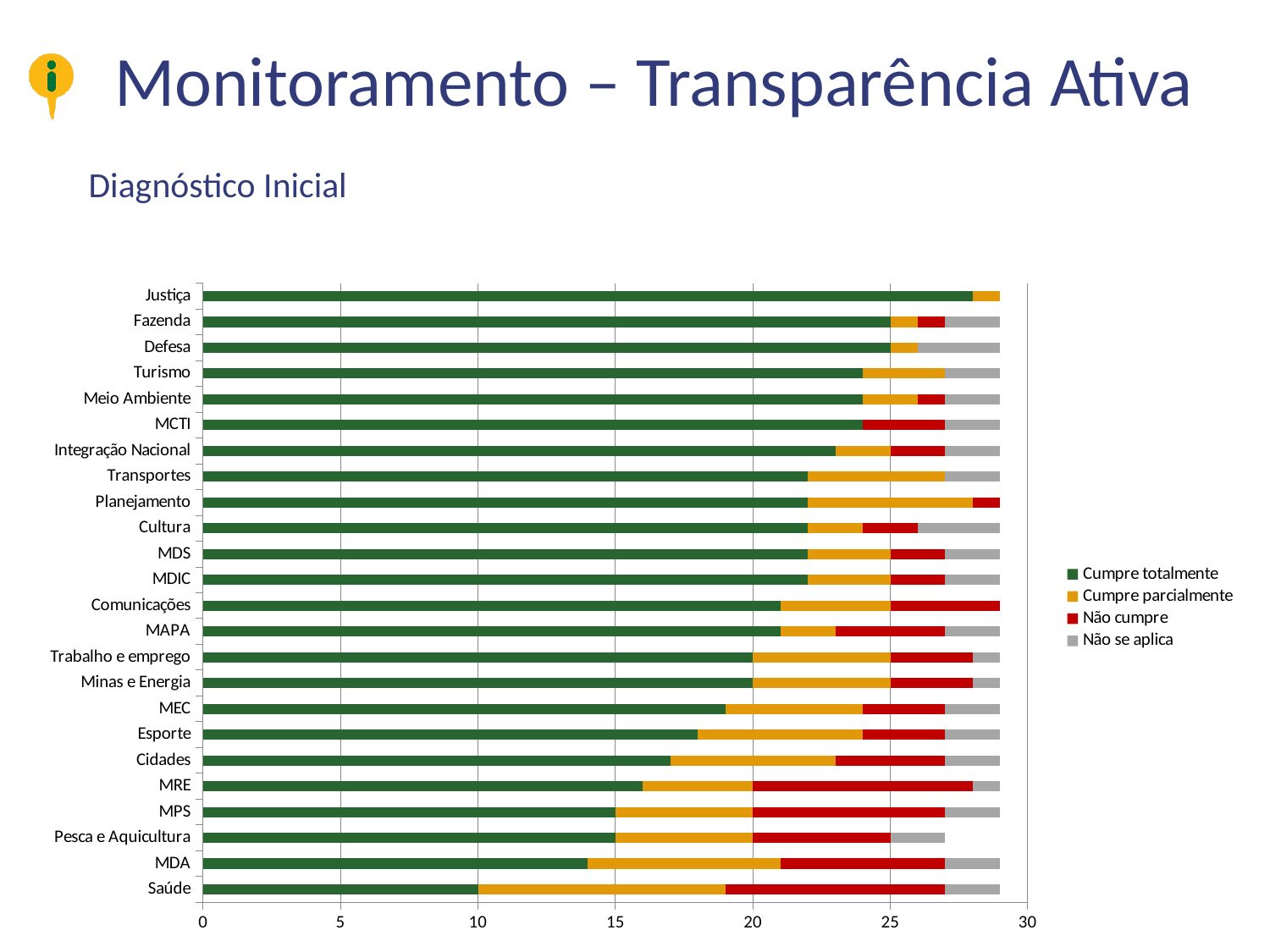
How many categories (ministries) are plotted on the chart? 24 What colour represents 'Não cumpre' in the chart? Red Which has the larger 'Não cumpre' value, Saúde or Defesa? Saúde What kind of chart is shown on the slide? Stacked bar chart Which has the larger 'Cumpre totalmente' value, Justiça or Saúde? Justiça What are the four legend entries of the chart? Cumpre totalmente, Cumpre parcialmente, Não cumpre, Não se aplica Which category has the lowest 'Cumpre totalmente' value? Saúde Is the 'Cumpre totalmente' value for Justiça greater or less than 25? greater How many series does the legend list? 4 Is the 'Cumpre totalmente' value for Cidades greater or less than 15? greater Is the 'Cumpre totalmente' value for MDA greater or less than 15? less Which category has the highest 'Cumpre totalmente' value? Justiça